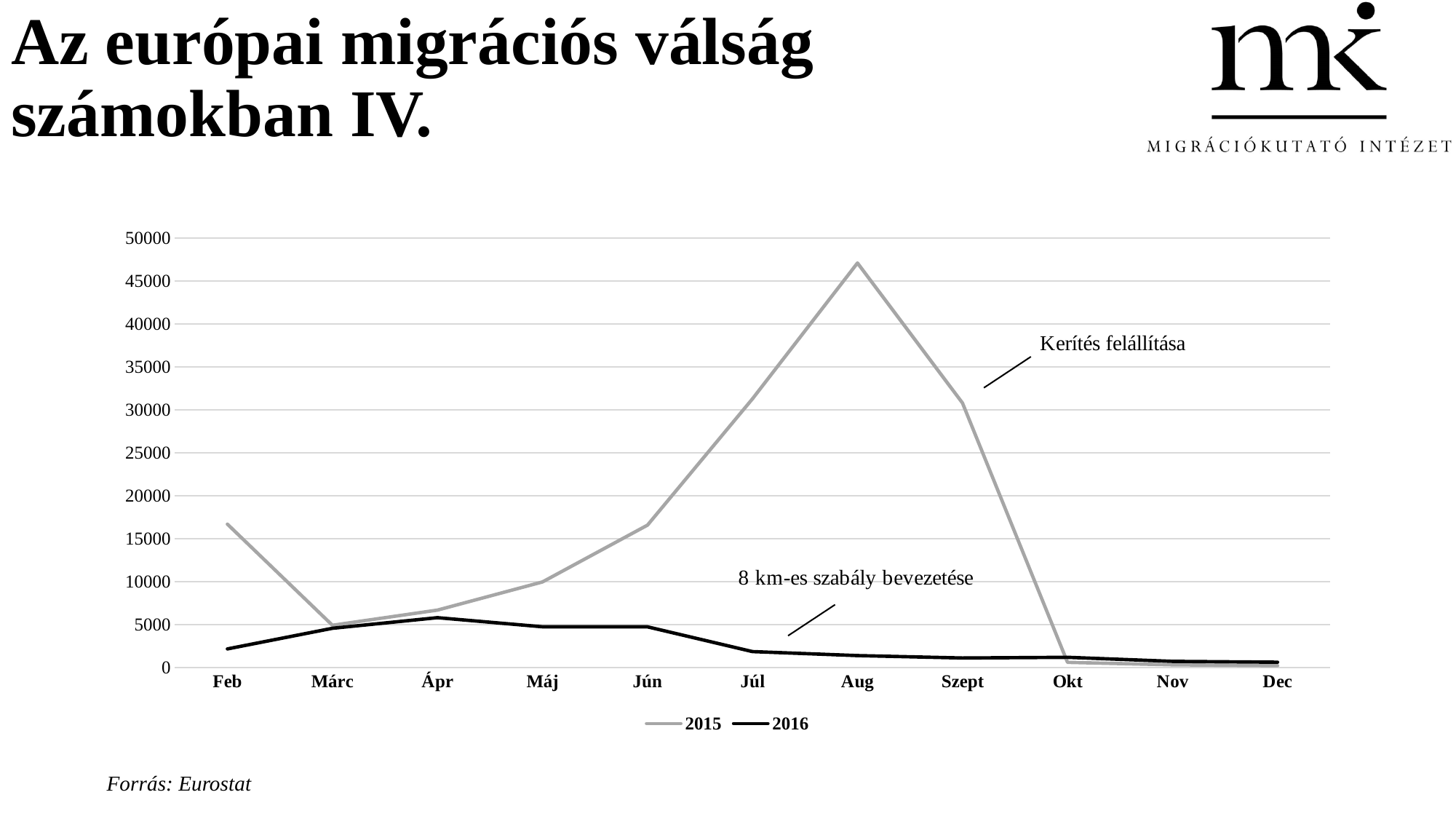
Does the 2015 series rise or fall from Aug to Okt? fall Which series has the larger value in Aug, 2015 or 2016? 2015 Is the value for 2015 in Feb greater or less than 15000? greater Is the value for 2015 in Okt greater or less than 5000? less How many series does the legend list? 2 In which month does the 2016 series reach its highest value? Ápr Is the value for 2016 in Feb greater or less than 5000? less Which series is drawn with the grey line? 2015 How many months are shown on the x axis? 11 What kind of chart is shown on the slide? line chart In which month does the 2015 series reach its highest value? Aug